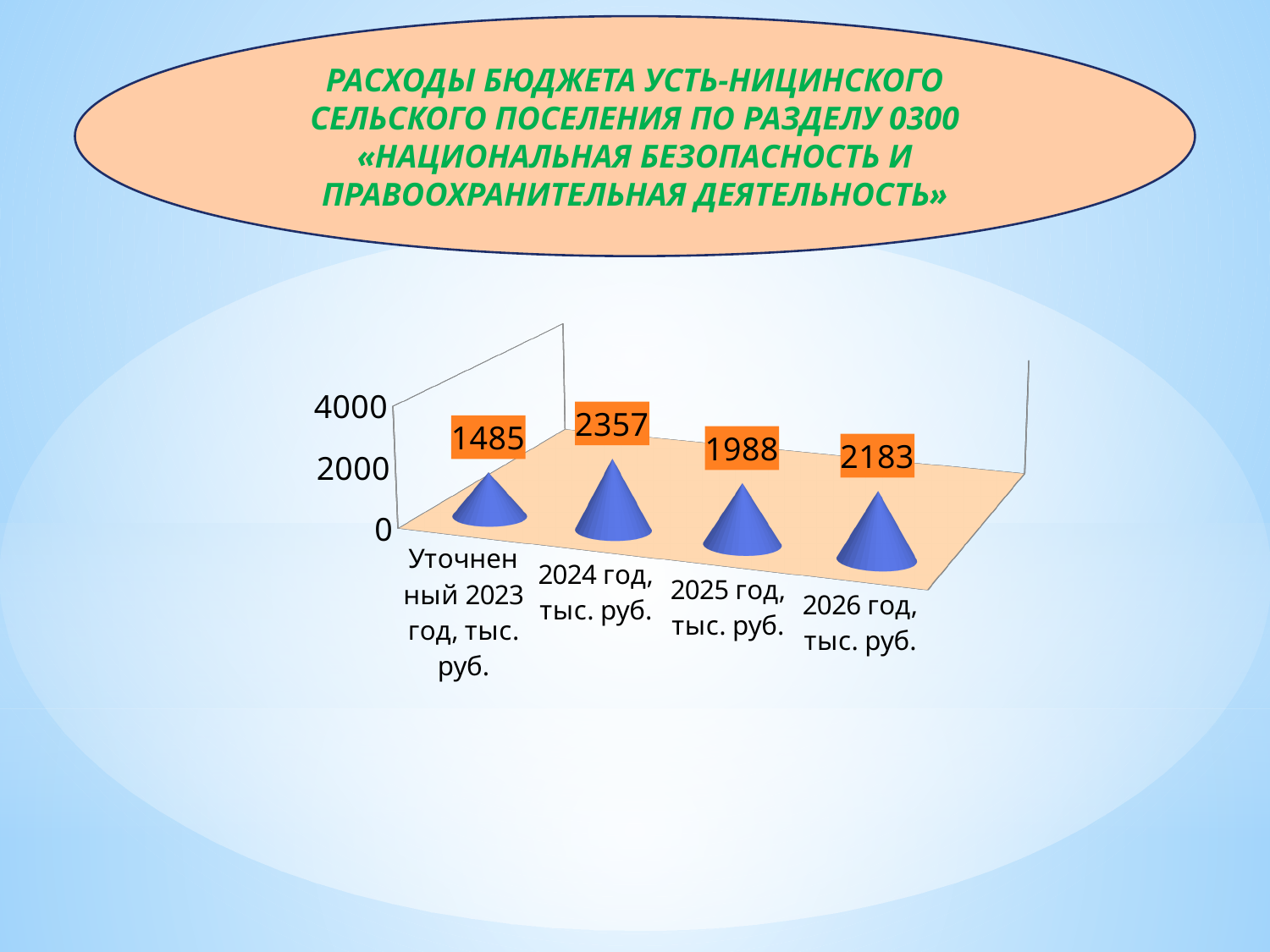
Which is larger, the value for 2025 год or the value for 2026 год? 2026 год, тыс. руб. Is the value for 2024 год greater or less than 2000? greater What kind of chart is shown on the slide? bar chart What is the value for 2024 год, тыс. руб.? 2357 What is the value for Уточненный 2023 год, тыс. руб.? 1485 What is the value for 2025 год, тыс. руб.? 1988 What is the difference between the values for 2024 год and Уточненный 2023 год? 872 Which category has the lowest value? Уточненный 2023 год, тыс. руб. What is the value for 2026 год, тыс. руб.? 2183 How many categories are shown on the chart? 4 What is the difference between the values for 2026 год and 2025 год? 195 Which category has the highest value? 2024 год, тыс. руб.